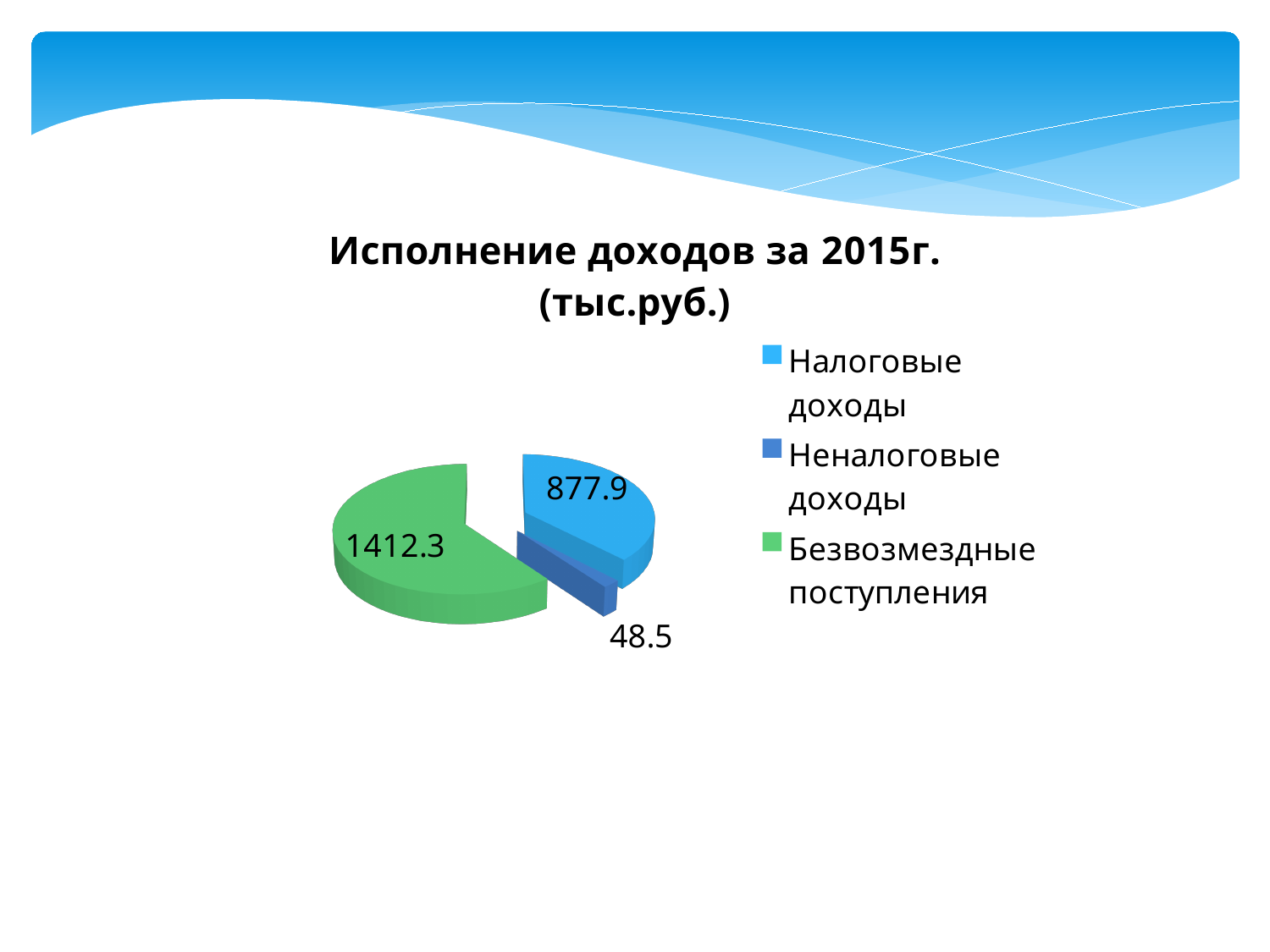
Which category has the smallest value? Неналоговые доходы What is the value for Неналоговые доходы? 48.5 What colour is the slice for Безвозмездные поступления? Green What is the difference between Безвозмездные поступления and Налоговые доходы? 534.4 What is the difference between Налоговые доходы and Неналоговые доходы? 829.4 What is the value for Безвозмездные поступления? 1412.3 Which category has the largest value? Безвозмездные поступления What is the title of the chart? Исполнение доходов за 2015г. (тыс.руб.) What type of chart is shown on the slide? Pie chart How many slices does the pie chart have? 3 What is the value for Налоговые доходы? 877.9 Which is larger, Налоговые доходы or Неналоговые доходы? Налоговые доходы